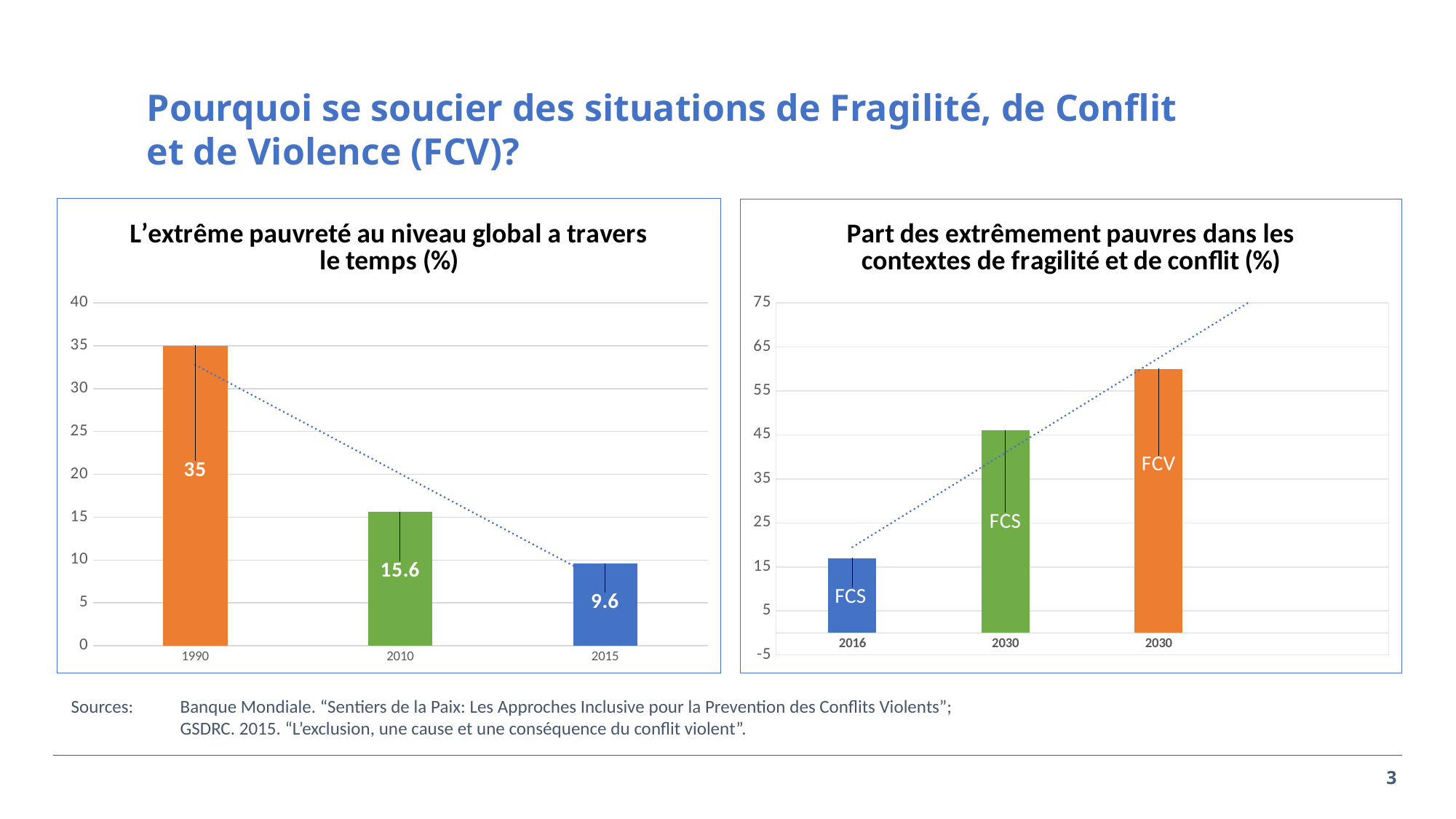
In the right chart, which bar is the highest? FCV (2030) In the right chart, which is larger: FCS in 2016 or FCS in 2030? FCS in 2030 In the left chart, what is the value for 1990? 35 In the left chart, what is the difference between the values for 1990 and 2015? 25.4 In the left chart, how many years are plotted? 3 In the right chart, is the value for FCS in 2016 greater or less than 25? less In the left chart, do the values rise or fall from 1990 to 2015? fall In the left chart, what is the value for 2010? 15.6 In the left chart, what is the value for 2015? 9.6 In the left chart, which year has the lowest value? 2015 What type of chart is the right chart? bar chart In the right chart, is the value for FCV in 2030 greater or less than 55? greater